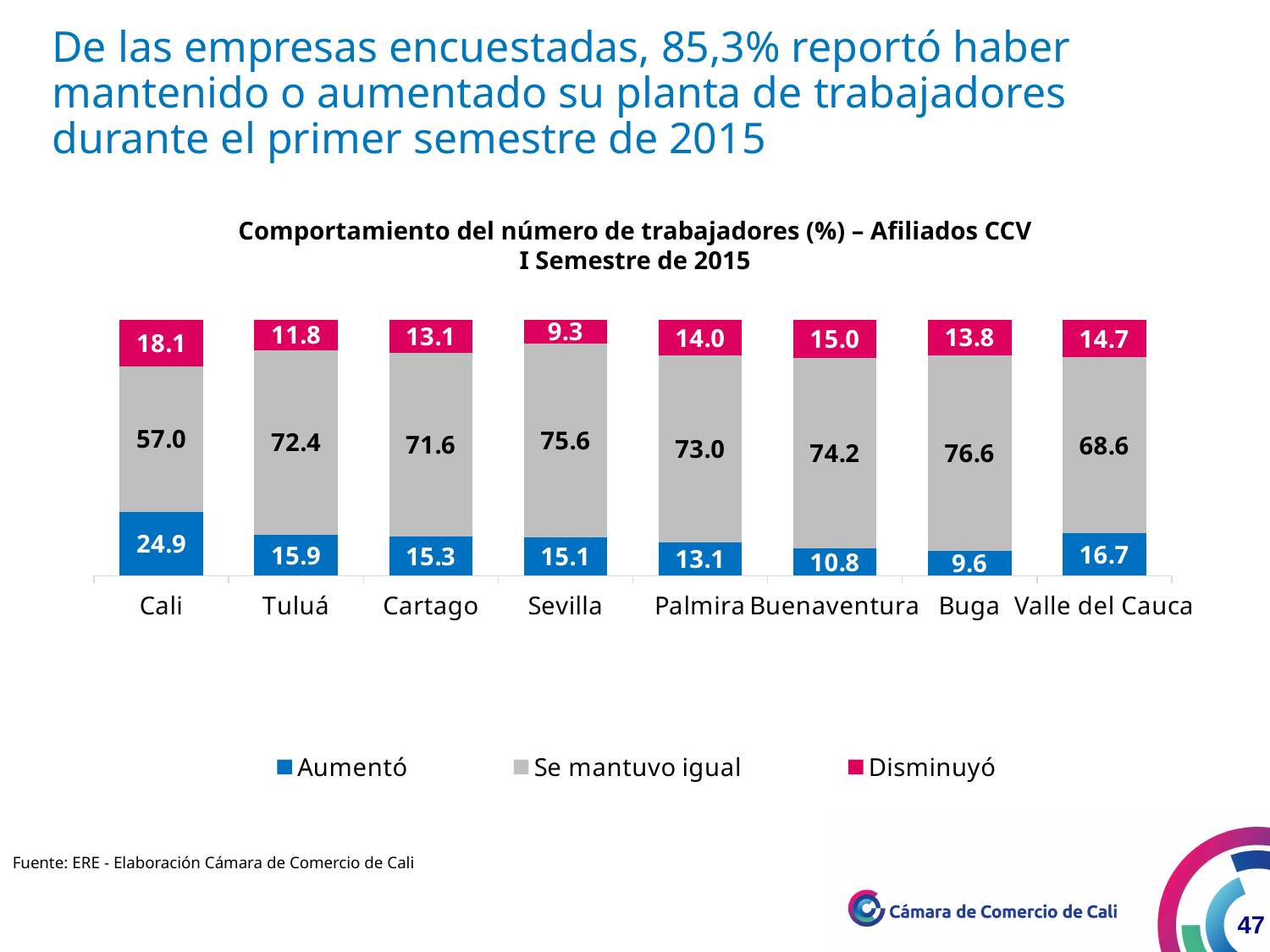
Which category has the lowest value for "Se mantuvo igual"? Cali How many categories are shown on the x axis? 8 What kind of chart is shown on the slide? Stacked bar chart What is the difference between the "Aumentó" values for Cali and Buga? 15.3 What is the value of "Se mantuvo igual" for Buga? 76.6 Which category has the highest value for "Aumentó"? Cali Which category has the lowest value for "Aumentó"? Buga What is the value of "Aumentó" for Cali? 24.9 What is the value of "Disminuyó" for Sevilla? 9.3 What is the total of the stacked bar for Cartago? 100.0 How many series does the legend list? 3 For Buenaventura, which is larger: "Aumentó" or "Disminuyó"? Disminuyó